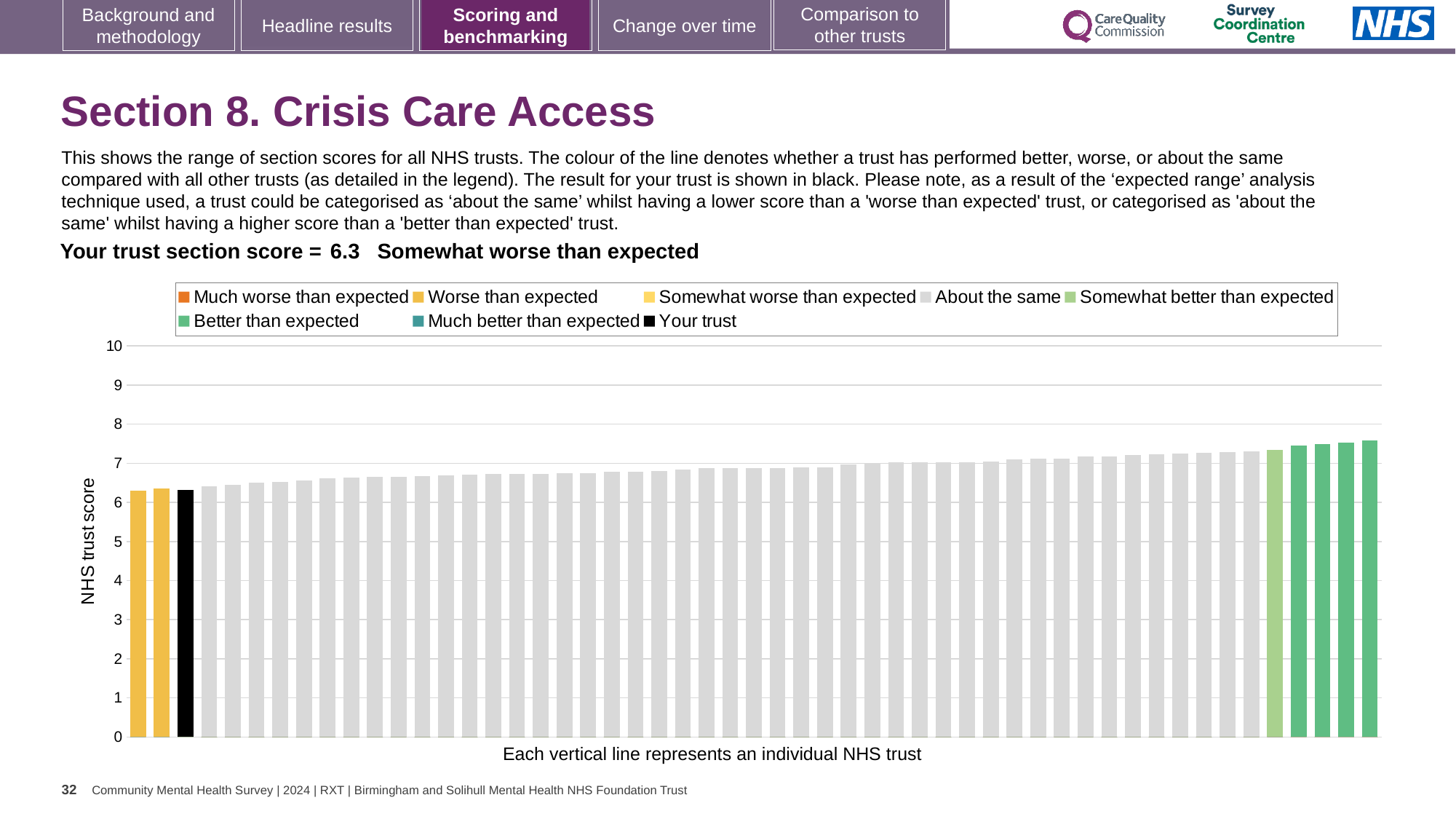
Do the bar values rise or fall from left to right across the chart? rise Which category is your trust's section score placed in, according to the text above the chart? Somewhat worse than expected What is the label on the vertical axis of the chart? NHS trust score What is the section score for your trust, as printed on the slide? 6.3 What kind of chart is shown on the slide? bar chart How many yellow bars are there at the left of the chart? 2 Which is larger: the black 'Your trust' bar or the rightmost bar? the rightmost bar Is the value of the rightmost (highest) bar greater or less than 7? greater How many dark green 'Better than expected' bars are there at the right of the chart? 4 How many entries does the chart legend list? 8 Is the value of the black 'Your trust' bar greater or less than 5? greater Is the value of the leftmost bar greater or less than 7? less